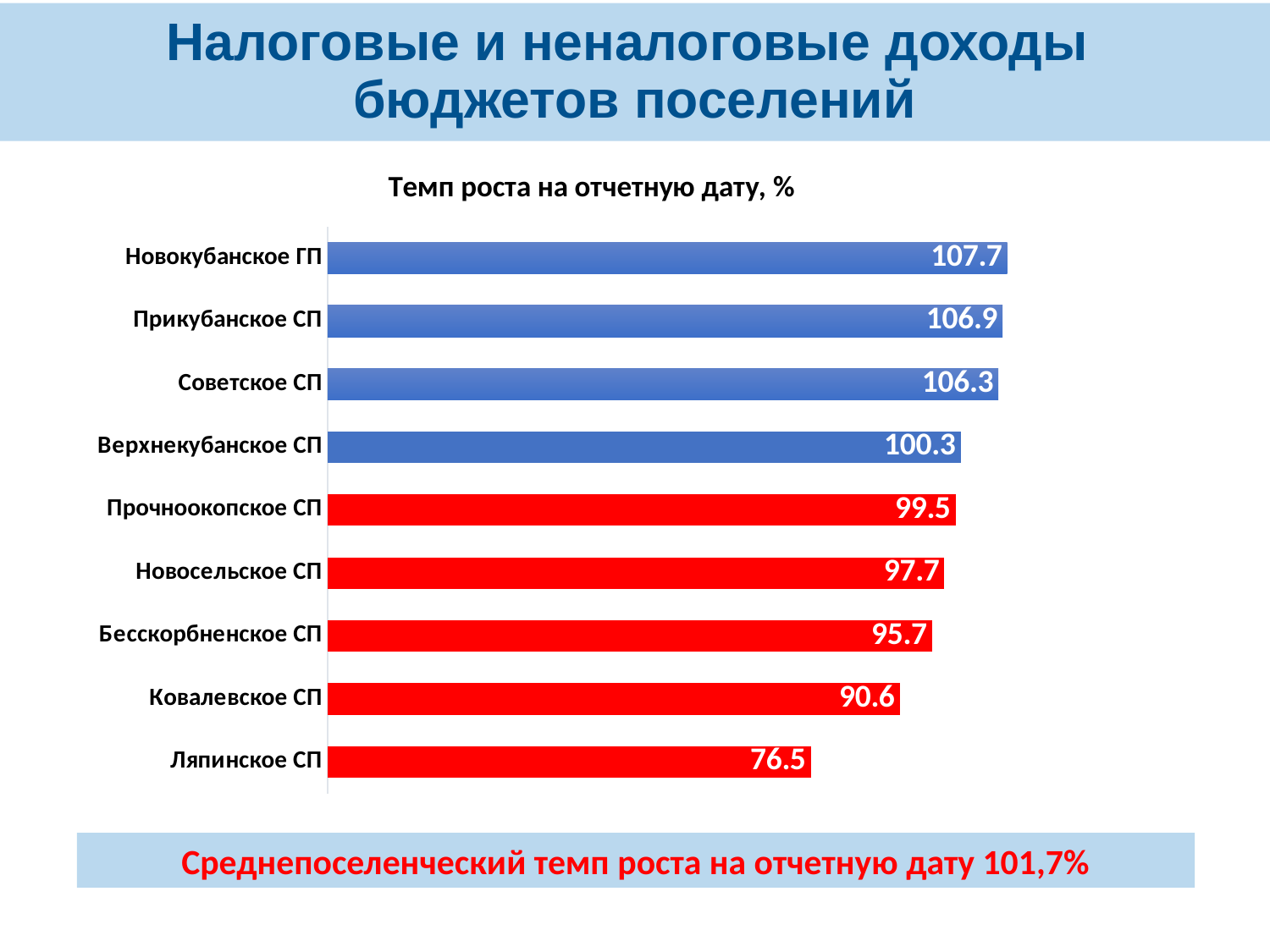
Which has a higher growth rate, Прочноокопское СП or Бесскорбненское СП? Прочноокопское СП What is the growth rate value for Новокубанское ГП? 107.7 What type of chart is shown on the slide? Bar chart Which settlement has the highest growth rate? Новокубанское ГП How many settlements are shown in the chart? 9 What is the growth rate value for Ковалевское СП? 90.6 What is the growth rate value for Верхнекубанское СП? 100.3 What is the growth rate value for Ляпинское СП? 76.5 What is the difference between the growth rates of Новокубанское ГП and Ляпинское СП? 31.2 What is the title of the chart? Темп роста на отчетную дату, % What is the difference between the growth rates of Прикубанское СП and Советское СП? 0.6 Which settlement has the lowest growth rate? Ляпинское СП